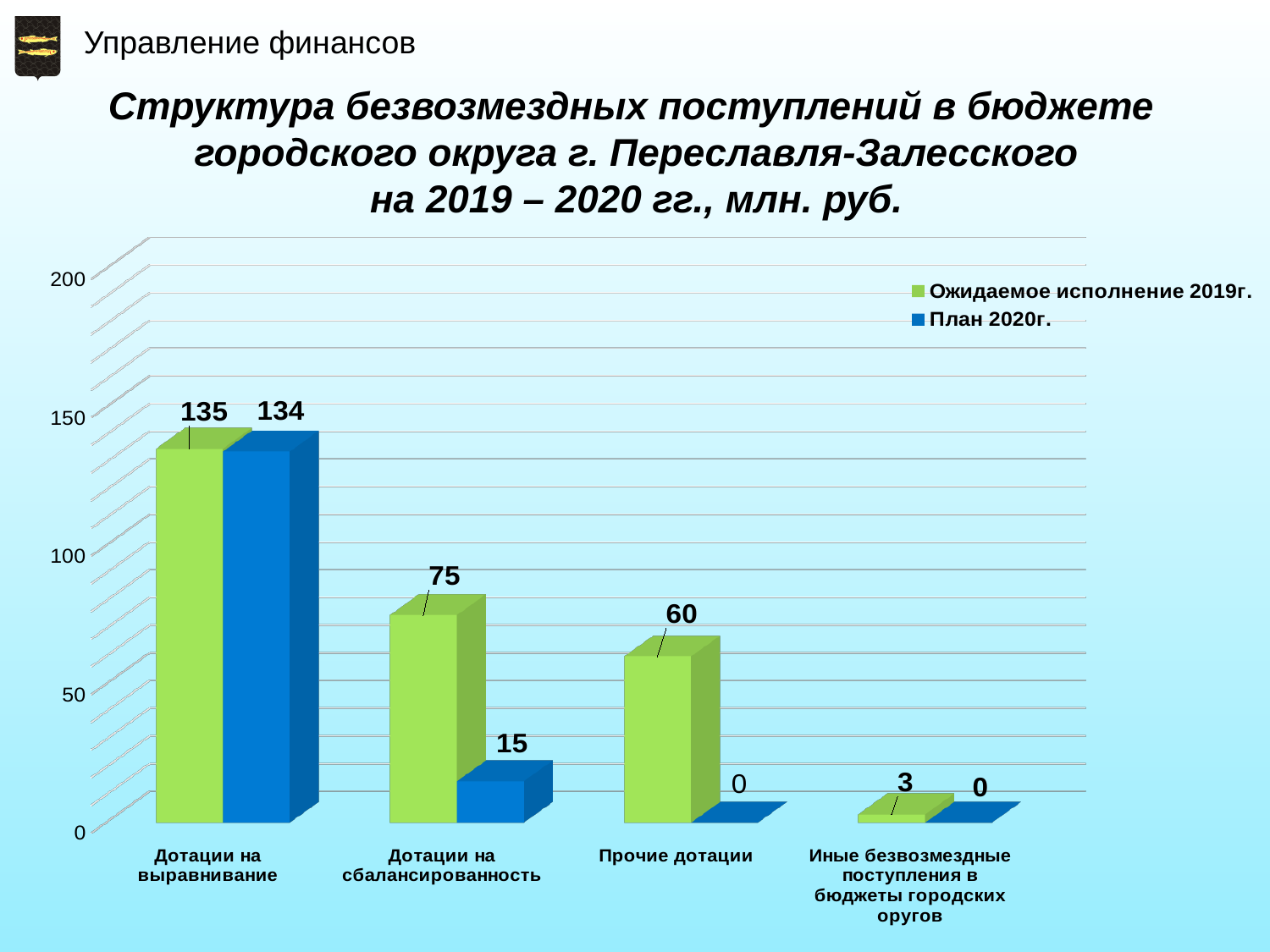
What is the difference between 'Ожидаемое исполнение 2019г.' and 'План 2020г.' for 'Дотации на сбалансированность'? 60 Which category has the lowest value for 'Ожидаемое исполнение 2019г.'? Иные безвозмездные поступления в бюджеты городских оругов What is the value of 'План 2020г.' for 'Дотации на сбалансированность'? 15 What is the value of 'План 2020г.' for 'Иные безвозмездные поступления в бюджеты городских оругов'? 0 What is the value of 'Ожидаемое исполнение 2019г.' for 'Дотации на выравнивание'? 135 What is the value of 'Ожидаемое исполнение 2019г.' for 'Прочие дотации'? 60 How many series does the legend list? 2 What kind of chart is shown on the slide? Bar chart Do the values for 'Ожидаемое исполнение 2019г.' rise or fall from left to right along the x axis? Fall Which is larger for 'Дотации на выравнивание': 'Ожидаемое исполнение 2019г.' or 'План 2020г.'? Ожидаемое исполнение 2019г. Which category has the highest value for 'Ожидаемое исполнение 2019г.'? Дотации на выравнивание How many categories are shown on the x axis? 4